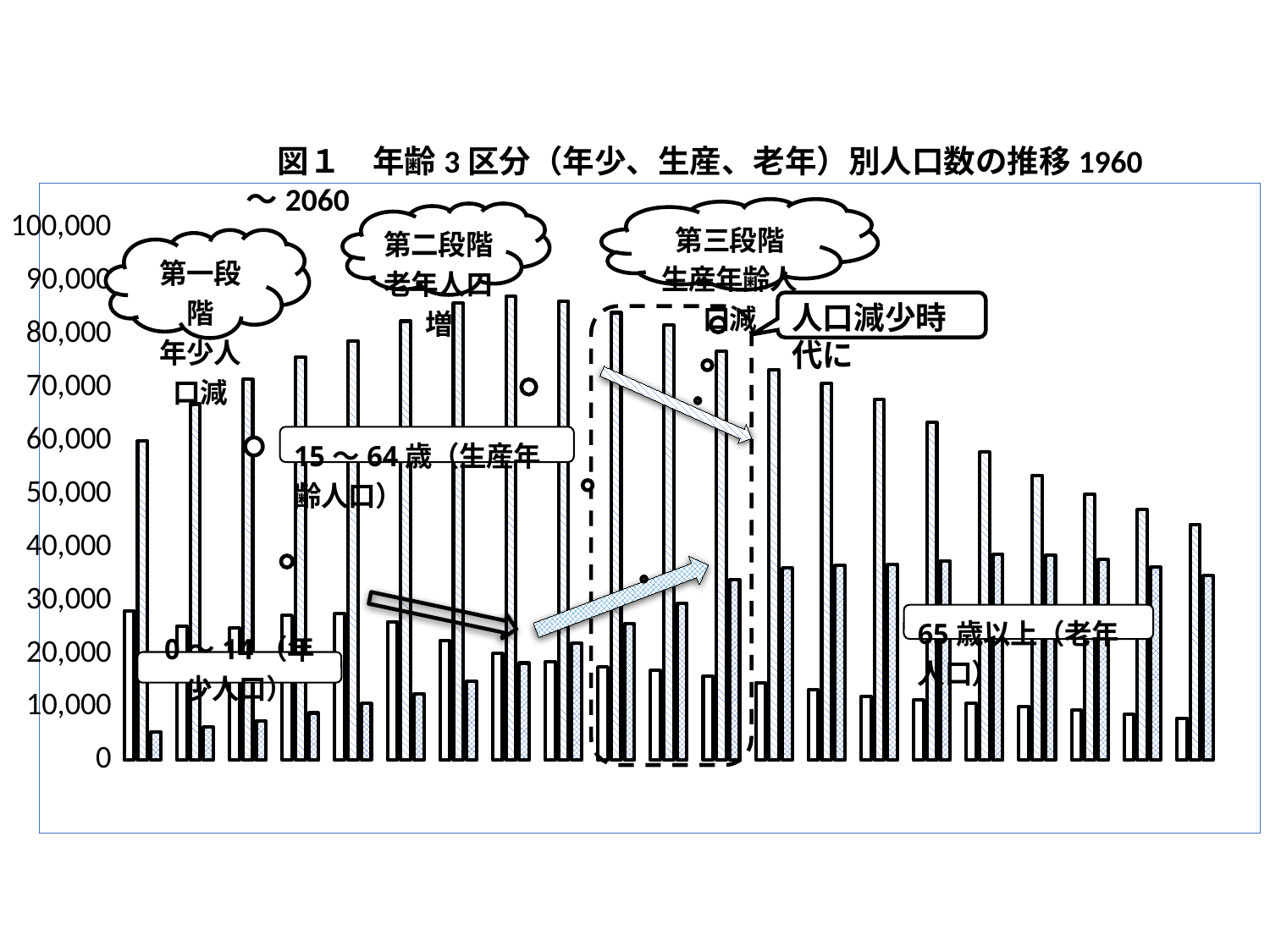
In the leftmost group of bars, is the value for 65歳以上 greater or less than 10,000? less Is the value of the tallest 15～64歳 bar greater or less than 80,000? greater What is the title of the chart? 図1 年齢3区分（年少、生産、老年）別人口数の推移 1960～2060 How many groups of bars (time points) are plotted along the x axis? 21 In the leftmost group of bars, which age-group series has the lowest value? 65歳以上（老年人口） Which age-group series has the tallest bars in the chart? 15～64歳（生産年齢人口） Do the values for 0～14歳（年少人口） rise or fall from left to right along the x axis? fall In the rightmost group of bars, is the value for 15～64歳 greater or less than 50,000? less What is the highest tick value shown on the vertical axis? 100,000 In the rightmost group of bars, which is larger: the 0～14歳 bar or the 65歳以上 bar? 65歳以上 How many age-group series are plotted in the chart? 3 What kind of chart is shown on the slide? bar chart